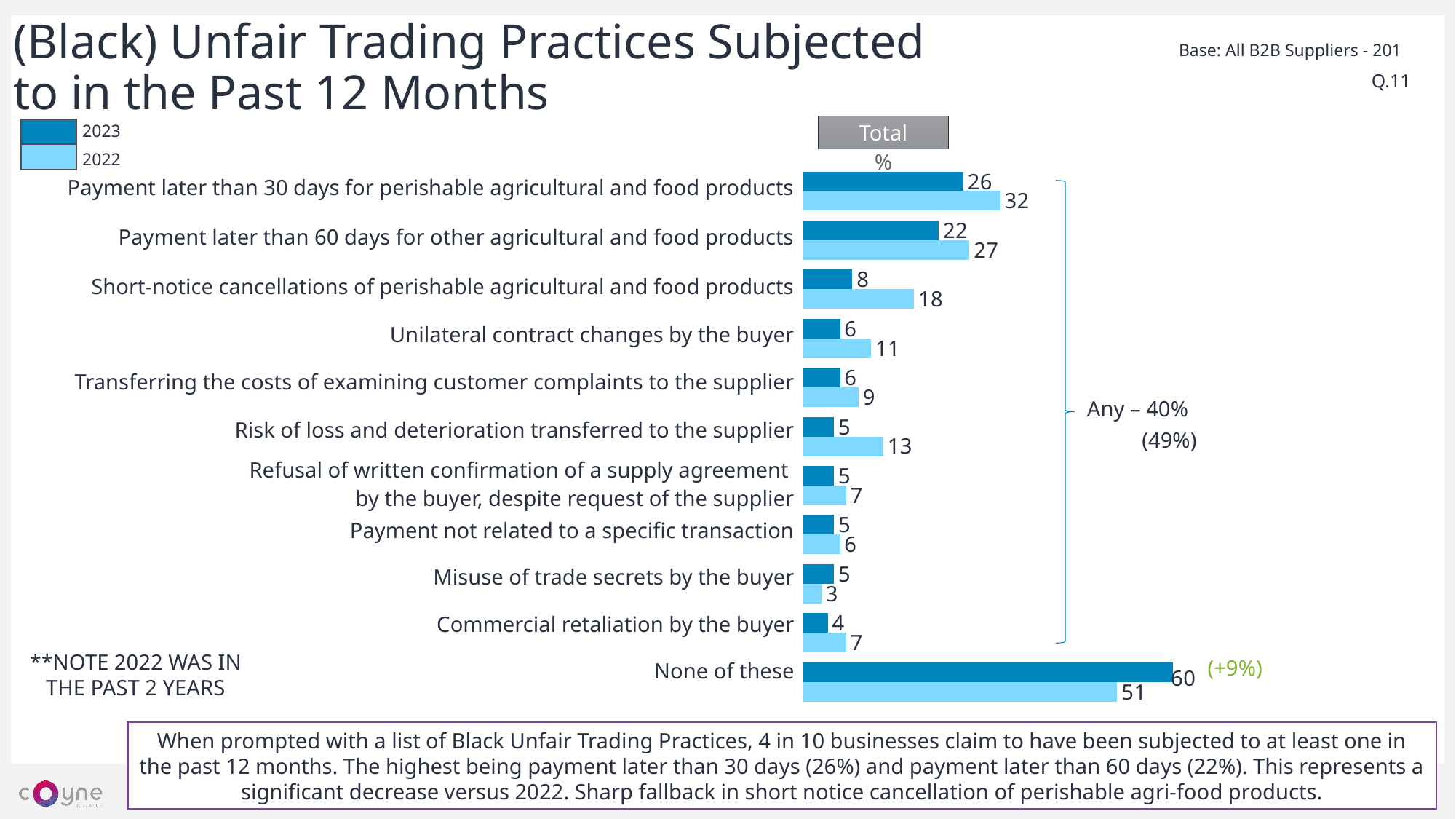
What is the 2022 value for "Short-notice cancellations of perishable agricultural and food products"? 18 Among the unfair trading practices (excluding "None of these"), which category has the highest 2023 value? Payment later than 30 days for perishable agricultural and food products For "Risk of loss and deterioration transferred to the supplier", which year has the larger value, 2023 or 2022? 2022 What is the difference between the 2022 and 2023 values for "Short-notice cancellations of perishable agricultural and food products"? 10 For "Misuse of trade secrets by the buyer", which year has the larger value, 2023 or 2022? 2023 What is the 2023 value for "None of these"? 60 How many categories are shown in the chart? 11 How many series does the legend list? 2 What is the difference between the 2023 and 2022 values for "None of these"? 9 What is the 2023 value for "Payment later than 30 days for perishable agricultural and food products"? 26 Which category has the lowest 2022 value? Misuse of trade secrets by the buyer What kind of chart is shown on the slide? Bar chart